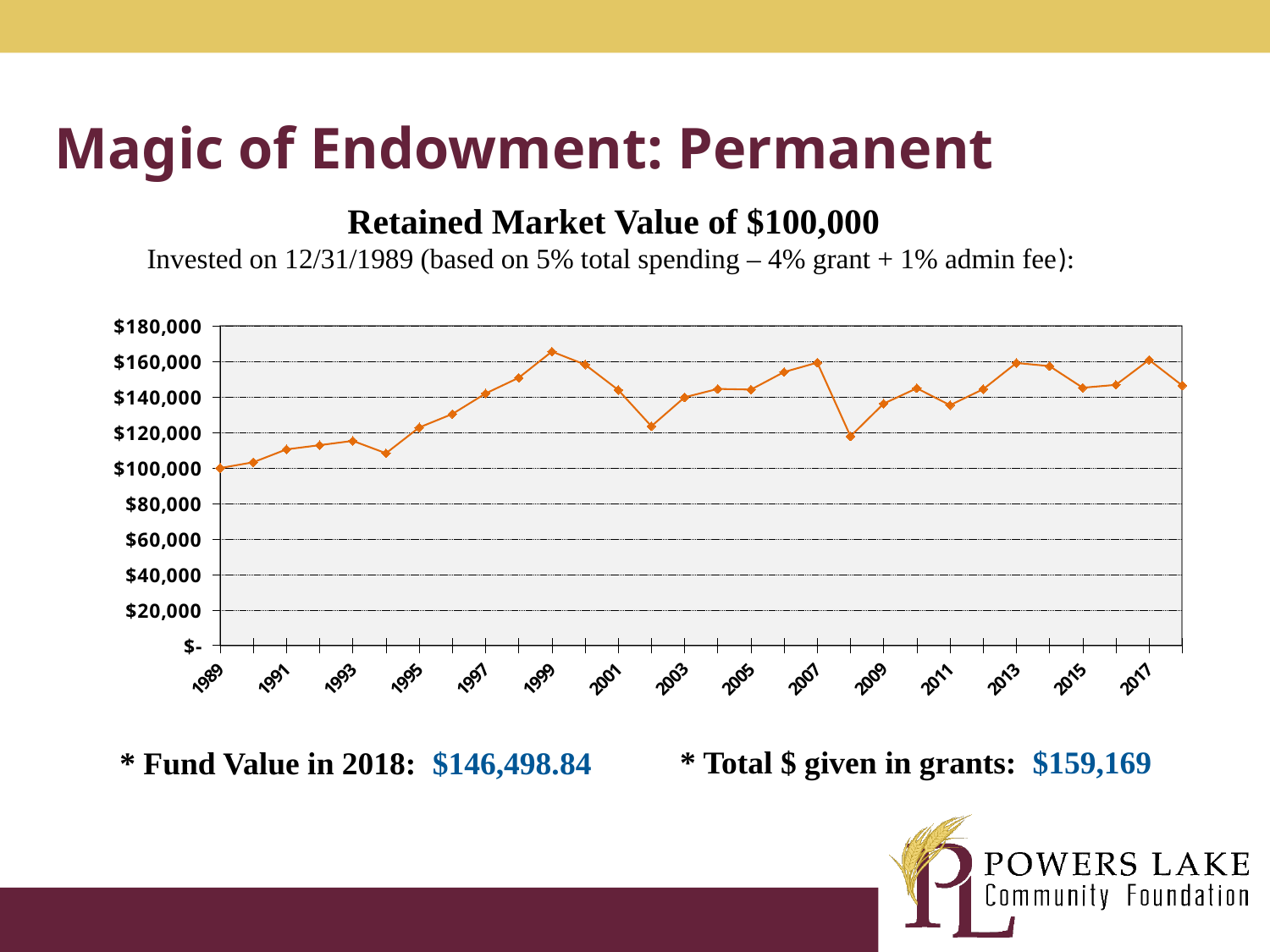
What kind of chart is shown on the slide? line chart Which year has the highest retained market value on the chart? 1999 Is the value for 2011 greater or less than $140,000? less What is the title of the chart? Retained Market Value of $100,000 According to the slide, what is the fund value in 2018? $146,498.84 Is the value for 1991 greater or less than $100,000? greater Is the value for 1999 greater or less than $160,000? greater What is the retained market value plotted for 1989? $100,000 Which year has the lowest retained market value on the chart? 1989 Which year has the larger retained market value, 1999 or 2008? 1999 How many data points are plotted on the line? 30 Does the retained market value rise or fall from 1989 to 1999? rise